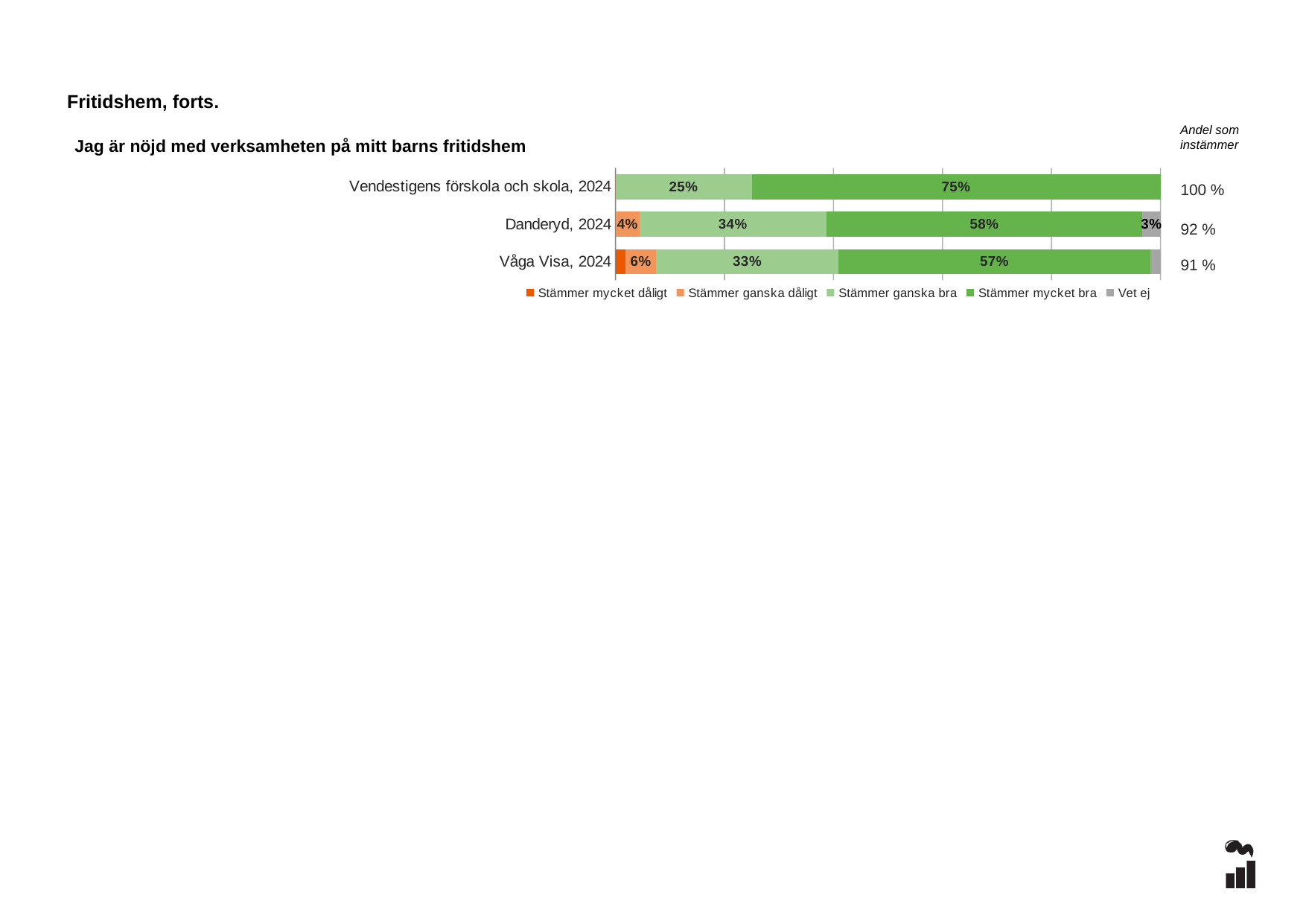
Which category has the lowest 'Stämmer ganska bra' value? Vendestigens förskola och skola, 2024 What is the difference between the 'Stämmer mycket bra' values for Vendestigens förskola och skola, 2024 and Danderyd, 2024? 17% How many categories (rows) does the chart show? 3 Which category has the highest 'Stämmer mycket bra' value? Vendestigens förskola och skola, 2024 What is the 'Stämmer mycket bra' value for Vendestigens förskola och skola, 2024? 75% What is the 'Vet ej' value for Danderyd, 2024? 3% What is the title of the chart? Jag är nöjd med verksamheten på mitt barns fritidshem What is the 'Andel som instämmer' value shown for Våga Visa, 2024? 91 % What kind of chart is shown on the slide? Stacked bar chart How many series does the legend list? 5 What is the 'Stämmer ganska bra' value for Danderyd, 2024? 34% What is the 'Stämmer ganska dåligt' value for Våga Visa, 2024? 6%